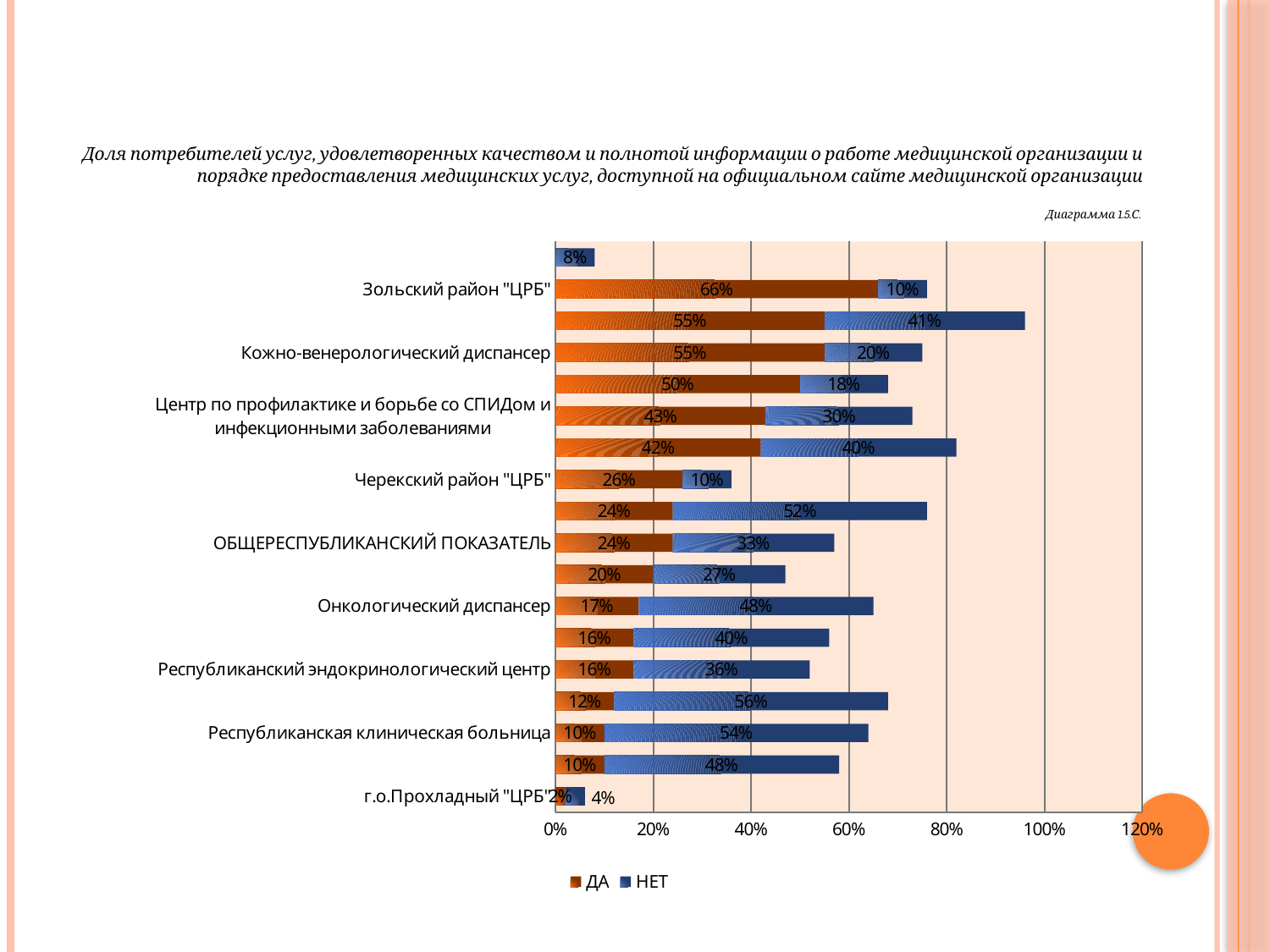
What is the total of the stacked bar for Черекский район "ЦРБ"? 36% What is the НЕТ value for Республиканская клиническая больница? 54% Is the total of the stacked bar for Кожно-венерологический диспансер greater or less than 60%? greater What is the ДА value for ОБЩЕРЕСПУБЛИКАНСКИЙ ПОКАЗАТЕЛЬ? 24% Which labeled category has the lowest ДА value? г.о.Прохладный "ЦРБ" What is the total of the stacked bar for Зольский район "ЦРБ"? 76% How many series does the legend list? 2 What is the НЕТ value for Онкологический диспансер? 48% What is the ДА value for Зольский район "ЦРБ"? 66% What is the difference between the НЕТ and ДА values for Республиканская клиническая больница? 44% Which has a larger ДА value: Кожно-венерологический диспансер or Центр по профилактике и борьбе со СПИДом и инфекционными заболеваниями? Кожно-венерологический диспансер What kind of chart is shown on the slide? Stacked bar chart